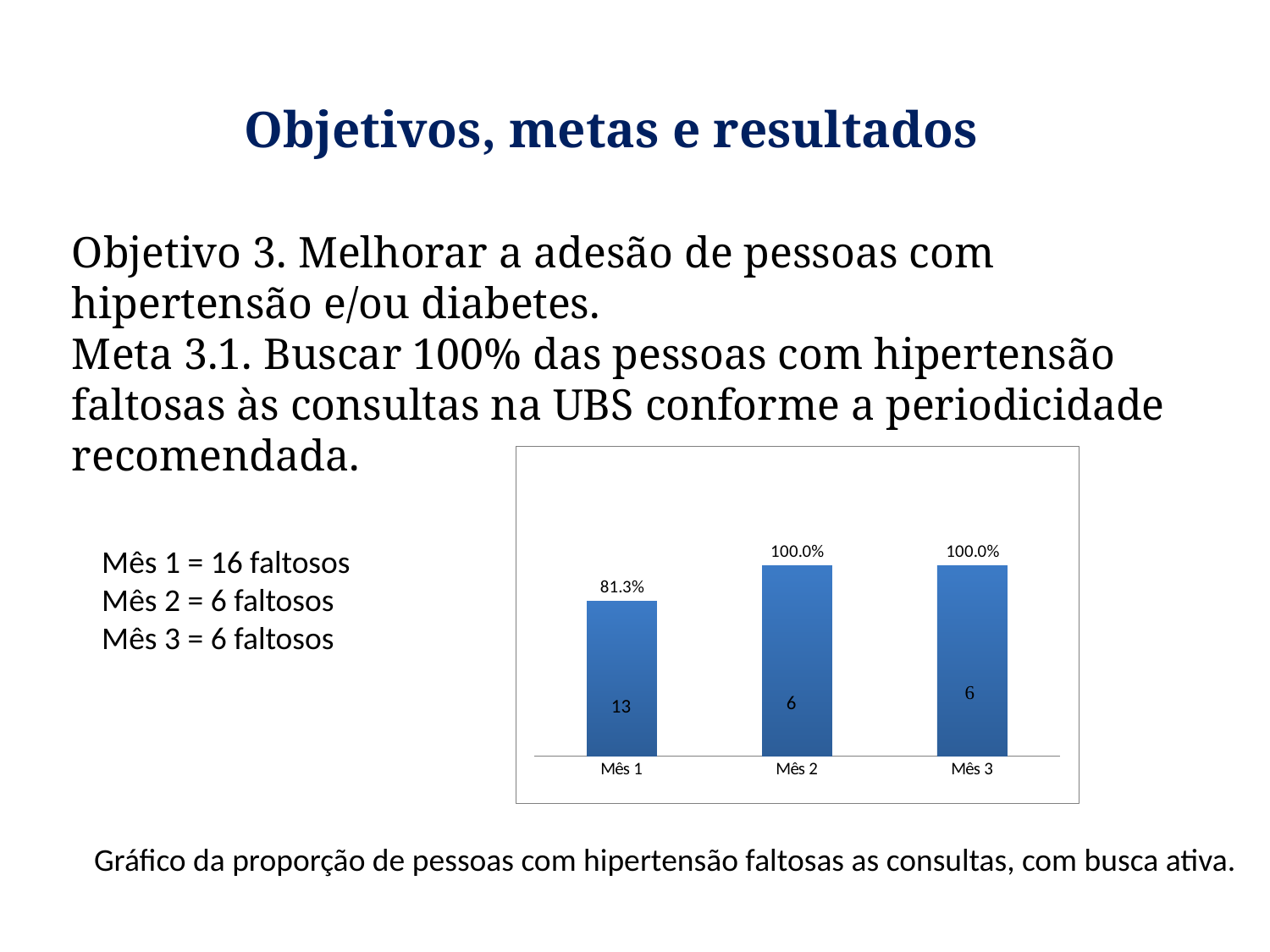
Do Mês 2 and Mês 3 have the same percentage? Yes What percentage is shown for Mês 3? 100.0% Which has the larger percentage, Mês 1 or Mês 3? Mês 3 What number is printed inside the bar for Mês 2? 6 Which month has the lowest percentage? Mês 1 What percentage is shown for Mês 1? 81.3% Does the percentage rise or fall from Mês 1 to Mês 2? Rise What percentage is shown for Mês 2? 100.0% How many months are shown on the chart? 3 What number is printed inside the bar for Mês 1? 13 What kind of chart is shown on the slide? Bar chart What is the difference in percentage between Mês 2 and Mês 1? 18.7%